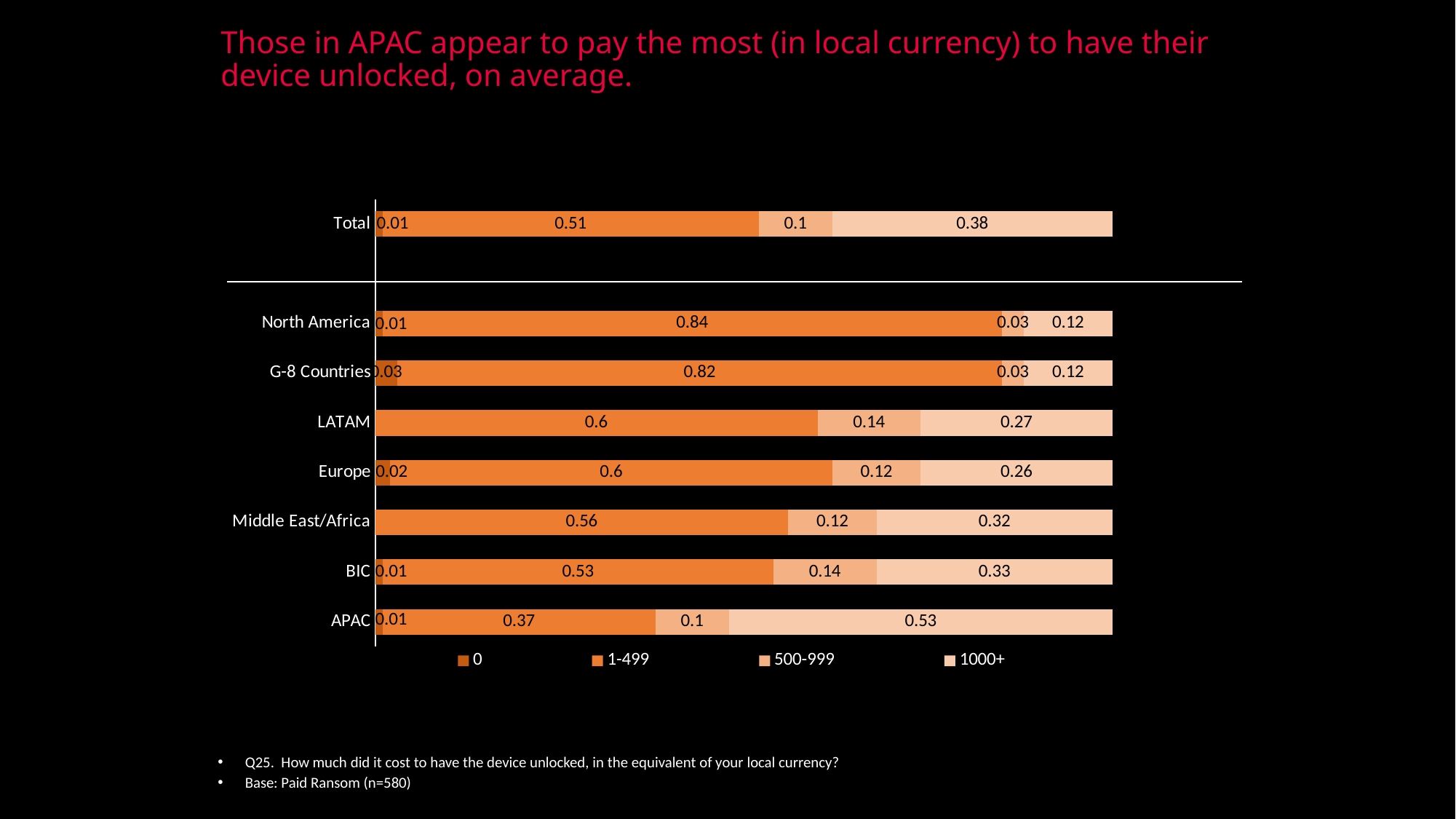
How many series does the legend list? 4 What kind of chart is shown on the slide? Stacked bar chart What is the value of the 500-999 series for LATAM? 0.14 Which region has the lowest value for the 1-499 series? APAC What is the value of the 1000+ series for APAC? 0.53 What is the value of the 1-499 series for North America? 0.84 What is the value of the 0 series for G-8 Countries? 0.03 Which is larger: the 1000+ value for Middle East/Africa or for Europe? Middle East/Africa How many region categories are plotted below the Total bar? 7 What is the difference between the 1000+ values for APAC and North America? 0.41 Which region has the highest value for the 1000+ series? APAC What is the value of the 1-499 series for the Total bar? 0.51